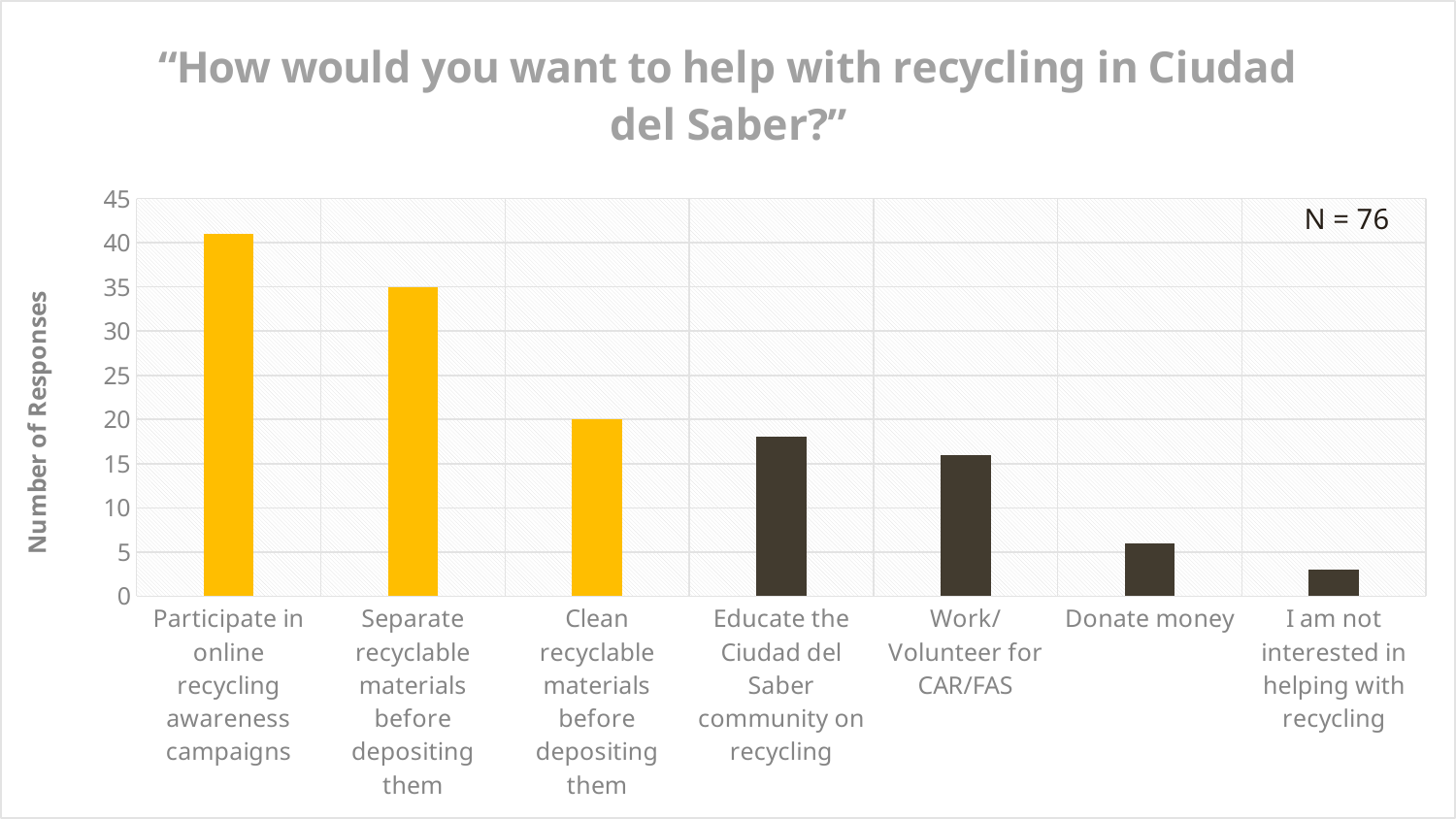
How many responses are there for 'Clean recyclable materials before depositing them'? 20 Is the value for 'Donate money' greater or less than 5? greater How many responses are there for 'Separate recyclable materials before depositing them'? 35 Which has more responses, 'Donate money' or 'I am not interested in helping with recycling'? Donate money Is the value for 'Participate in online recycling awareness campaigns' greater or less than 40? greater What is the sample size (N) shown on the chart? N = 76 What kind of chart is shown on the slide? Bar chart What is the difference in responses between 'Separate recyclable materials before depositing them' and 'Clean recyclable materials before depositing them'? 15 Which category has the lowest number of responses? I am not interested in helping with recycling Which category has the highest number of responses? Participate in online recycling awareness campaigns Is the value for 'Educate the Ciudad del Saber community on recycling' greater or less than 20? less How many response categories are shown on the x axis? 7